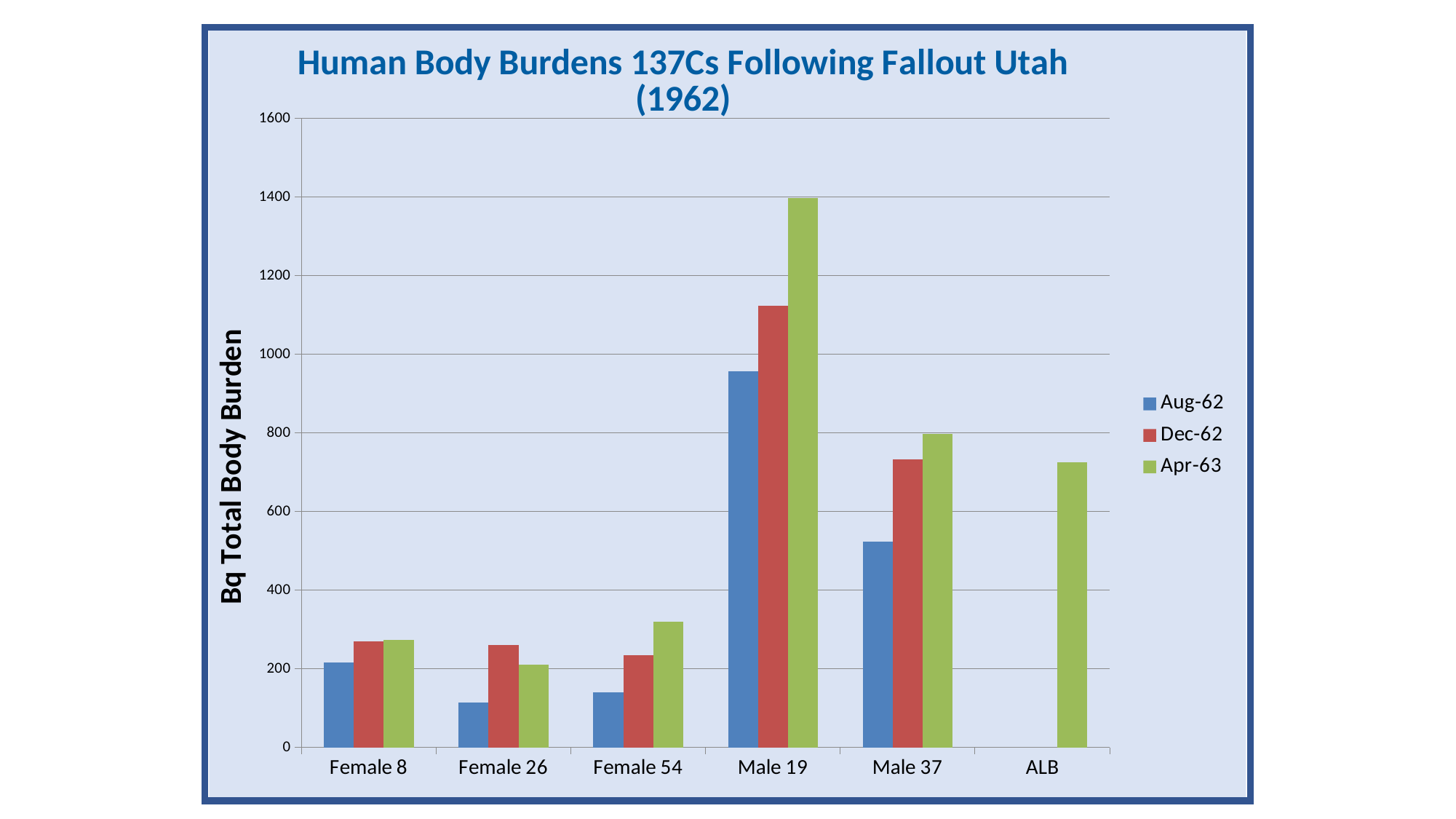
How many series does the legend list? 3 Is the Apr-63 value for ALB greater or less than 600? greater Which category has the lowest Aug-62 value? Female 26 Is the Aug-62 value for Male 37 greater or less than 600? less How many categories are shown on the x axis? 6 Which category has the highest Apr-63 value? Male 19 For Male 19, do the values rise or fall from Aug-62 to Apr-63? rise Which category has a bar for only one series? ALB For Female 26, which is larger, the Dec-62 value or the Apr-63 value? Dec-62 What kind of chart is shown on the slide? bar chart Is the Apr-63 value for Male 19 greater or less than 1200? greater Which is larger, the Dec-62 value for Male 19 or the Dec-62 value for Male 37? Male 19